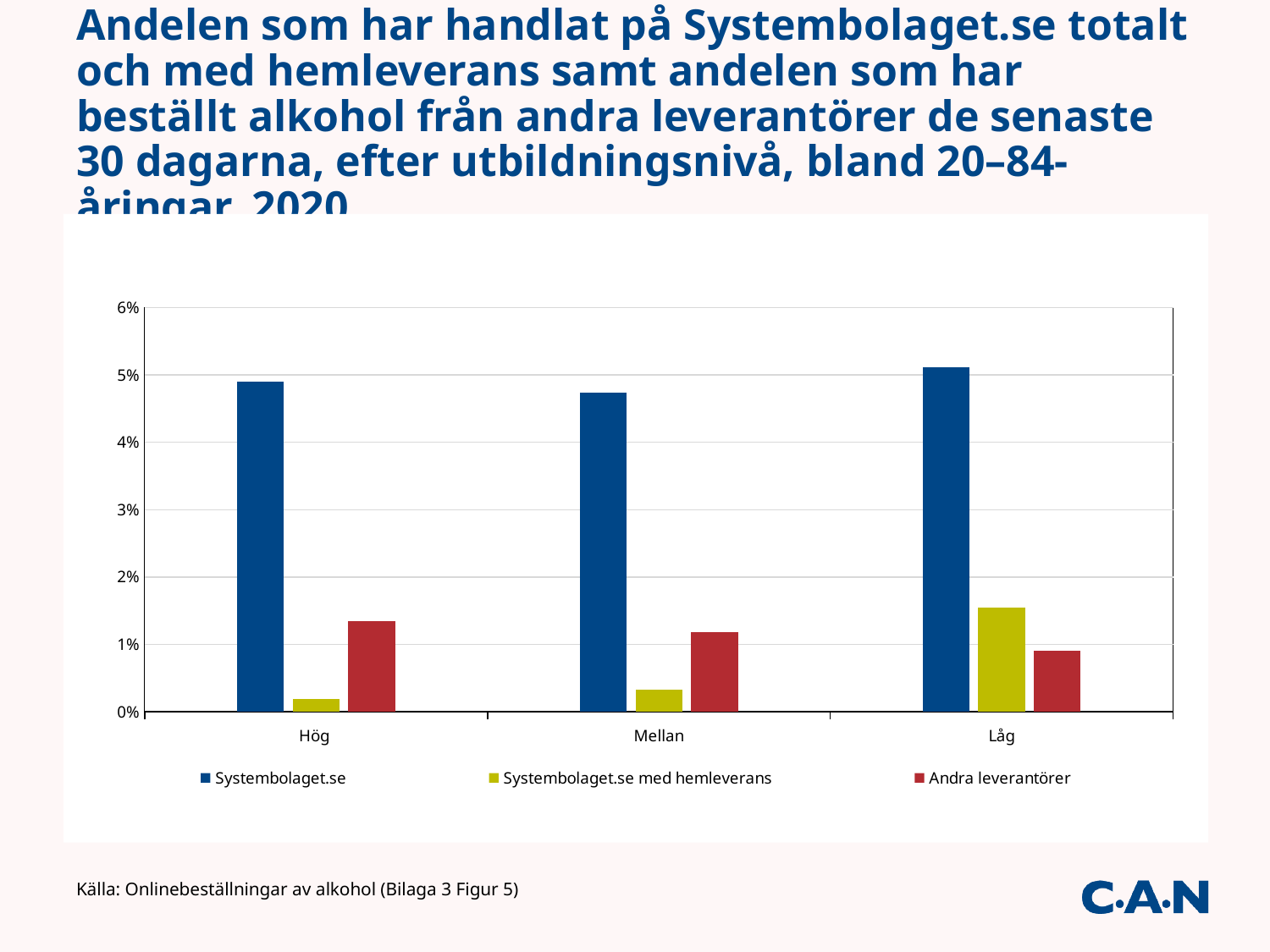
Is the value for Systembolaget.se in the Låg category greater or less than 5%? greater Which category has the highest value for Systembolaget.se? Låg What kind of chart is shown on the slide? bar chart Which category has the lowest value for Andra leverantörer? Låg Is the value for Systembolaget.se in the Hög category greater or less than 5%? less Is the value for Systembolaget.se med hemleverans in the Låg category greater or less than 1%? greater How many education-level categories are shown on the x axis? 3 In the Låg category, which is larger: Systembolaget.se med hemleverans or Andra leverantörer? Systembolaget.se med hemleverans Which category has the highest value for Systembolaget.se med hemleverans? Låg How many series does the legend list? 3 In the Hög category, which is larger: Systembolaget.se med hemleverans or Andra leverantörer? Andra leverantörer